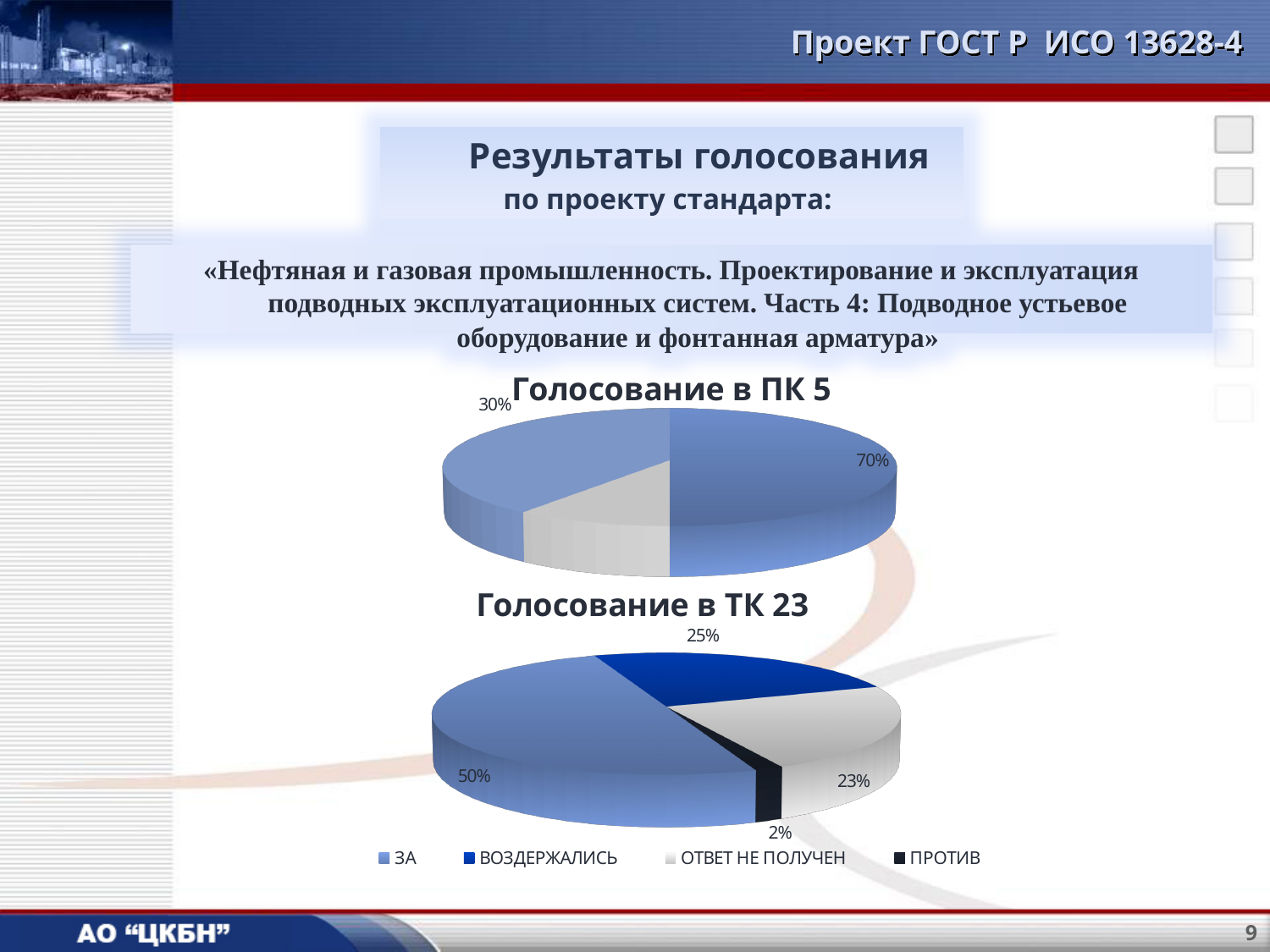
In the chart titled "Голосование в ТК 23", which category has the largest slice? ЗА How many entries does the legend at the bottom of the slide list? 4 In the chart titled "Голосование в ТК 23", what is the difference between the ВОЗДЕРЖАЛИСЬ and ОТВЕТ НЕ ПОЛУЧЕН percentages? 2% What type of chart is "Голосование в ПК 5"? Pie chart In the chart titled "Голосование в ТК 23", what percentage is shown for ВОЗДЕРЖАЛИСЬ? 25% In the chart titled "Голосование в ТК 23", what percentage is shown for ЗА? 50% In the chart titled "Голосование в ТК 23", what percentage is shown for ПРОТИВ? 2% How many slices does the chart titled "Голосование в ТК 23" have? 4 In the chart titled "Голосование в ТК 23", which category has the smallest slice? ПРОТИВ